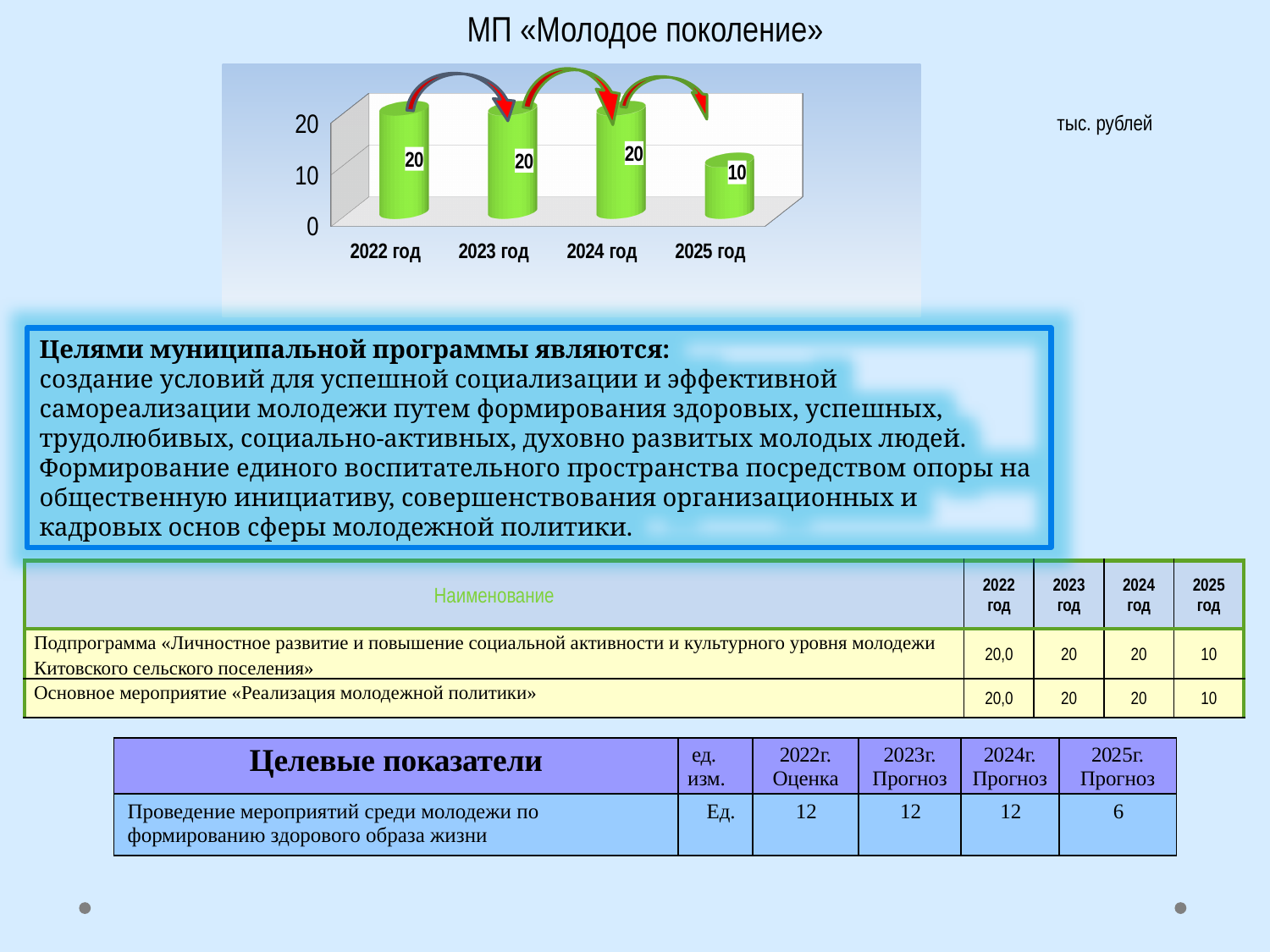
What is the value for 2025 год on the chart? 10 Is the value for 2025 год greater or less than 20? less How many categories (years) are shown on the chart? 4 What is the value for 2022 год on the chart? 20 What is the value for 2024 год on the chart? 20 What is the highest value shown on the chart's vertical axis? 20 Which is larger, the value for 2023 год or the value for 2025 год? 2023 год Do the values on the chart rise or fall from 2024 год to 2025 год? fall What unit of measurement is indicated next to the chart? тыс. рублей What kind of chart is shown on the slide? bar chart What is the difference between the values for 2024 год and 2025 год? 10 Which year has the lowest value on the chart? 2025 год